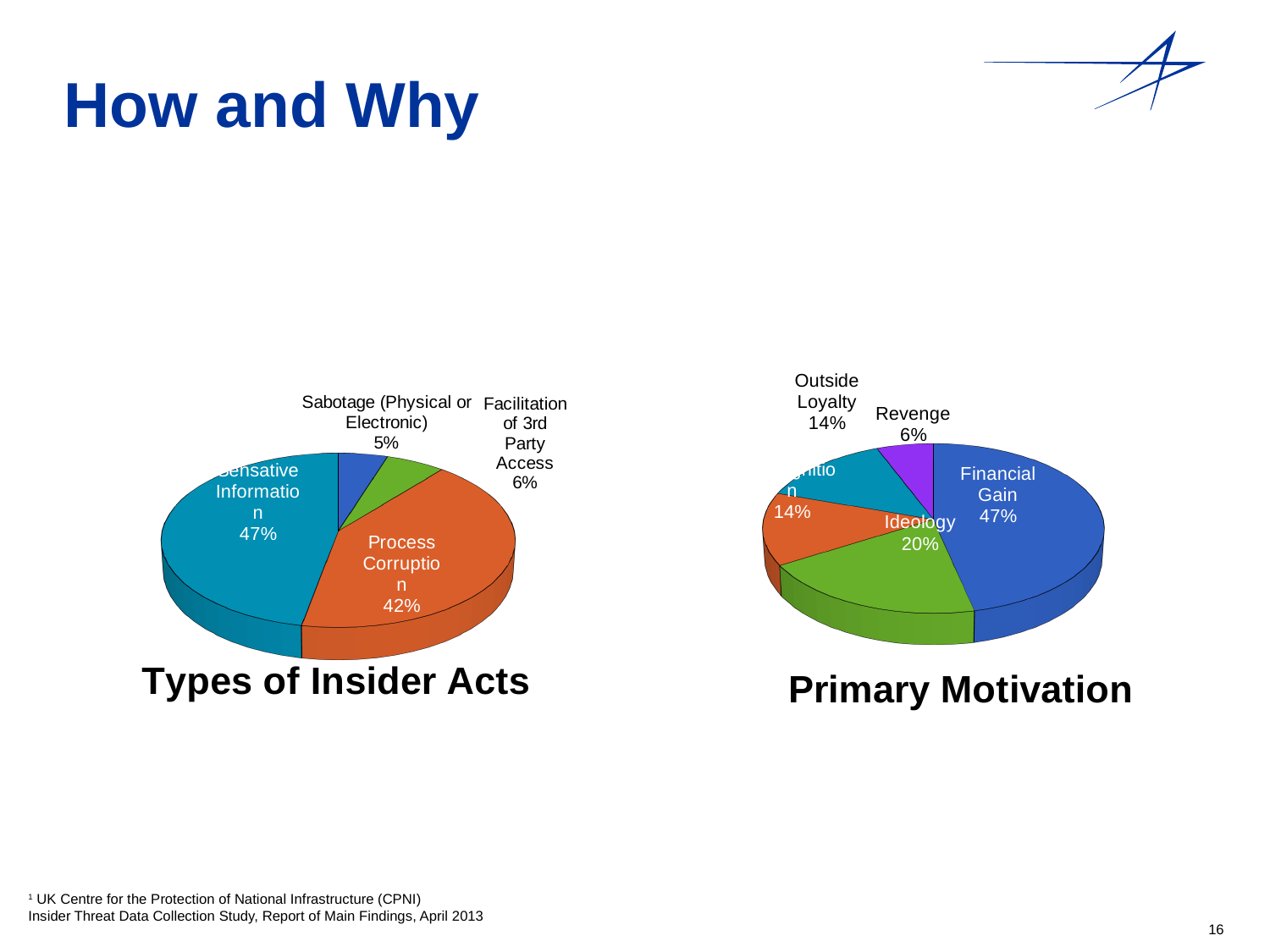
In the Types of Insider Acts chart, what percentage is shown for Process Corruption? 42% In the Types of Insider Acts chart, which category has the smallest share? Sabotage (Physical or Electronic) In the Types of Insider Acts chart, what percentage is shown for Facilitation of 3rd Party Access? 6% In the Types of Insider Acts chart, how many percentage points larger is Process Corruption than Facilitation of 3rd Party Access? 36 percentage points In the Primary Motivation chart, which is larger, Ideology or Outside Loyalty? Ideology In the Primary Motivation chart, what percentage is shown for Ideology? 20% In the Primary Motivation chart, which motivation has the largest share? Financial Gain In the Types of Insider Acts chart, what percentage is shown for Sabotage (Physical or Electronic)? 5% What kind of chart is the Types of Insider Acts chart? Pie chart In the Primary Motivation chart, how many slices does the pie have? 5 In the Primary Motivation chart, what percentage is shown for Financial Gain? 47% In the Primary Motivation chart, what percentage is shown for Revenge? 6%